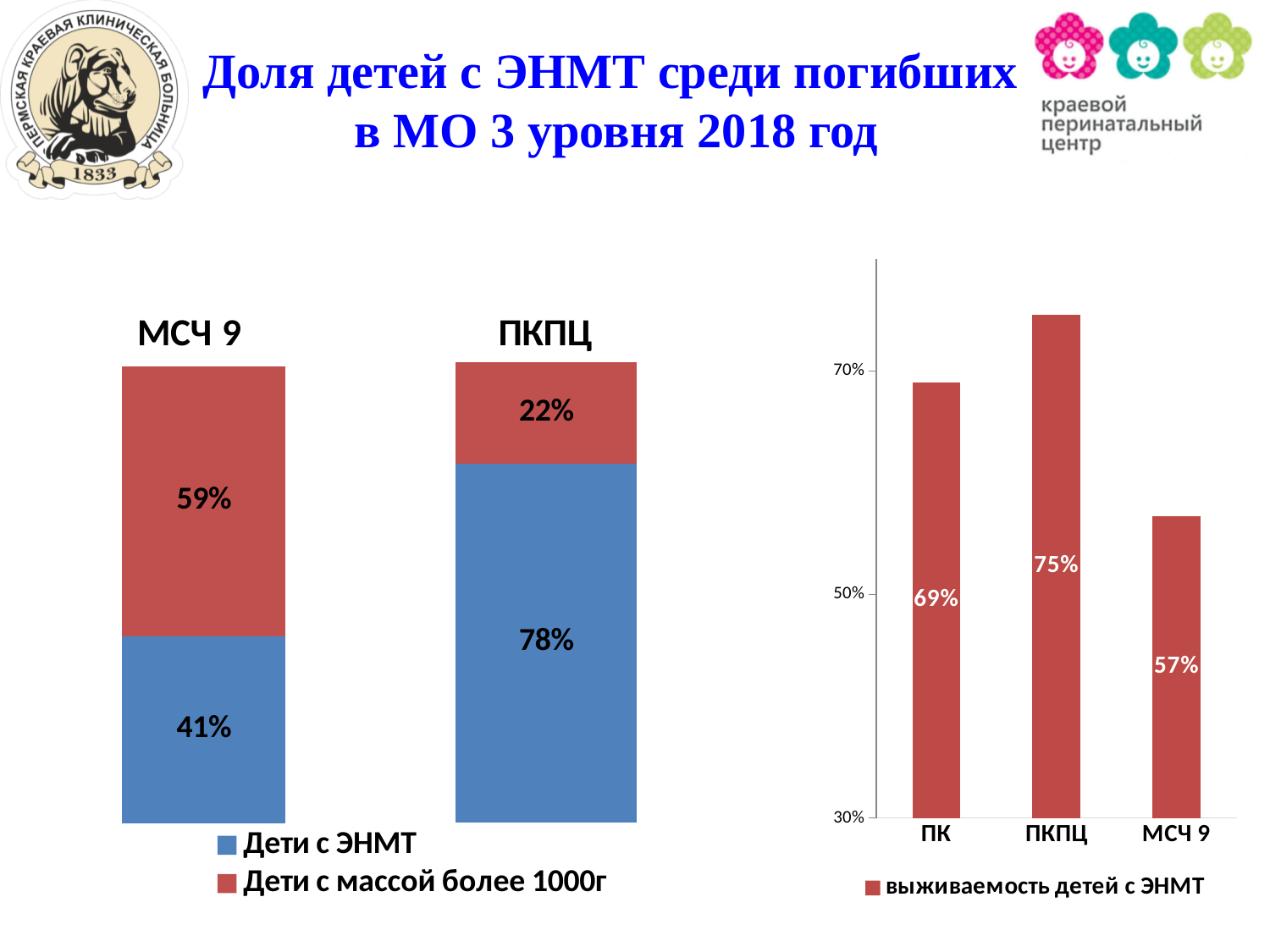
How many categories are shown on the x axis of the right chart (выживаемость детей с ЭНМТ)? 3 In the left stacked bar chart, which category has the larger share of Дети с ЭНМТ, МСЧ 9 or ПКПЦ? ПКПЦ In the left stacked bar chart, what is the value for Дети с ЭНМТ at МСЧ 9? 41% In the left stacked bar chart, what is the value for Дети с ЭНМТ at ПКПЦ? 78% In the right chart (выживаемость детей с ЭНМТ), what is the difference between the values for ПКПЦ and МСЧ 9? 18% In the left stacked bar chart, what is the total of the ПКПЦ bar? 100% In the right chart (выживаемость детей с ЭНМТ), which category has the highest value? ПКПЦ In the right chart (выживаемость детей с ЭНМТ), what is the value for ПК? 69% In the left stacked bar chart, what is the value for Дети с массой более 1000г at ПКПЦ? 22% In the right chart (выживаемость детей с ЭНМТ), which category has the lowest value? МСЧ 9 How many series does the legend of the left stacked bar chart list? 2 In the left stacked bar chart, what is the difference between the Дети с ЭНМТ values for ПКПЦ and МСЧ 9? 37%